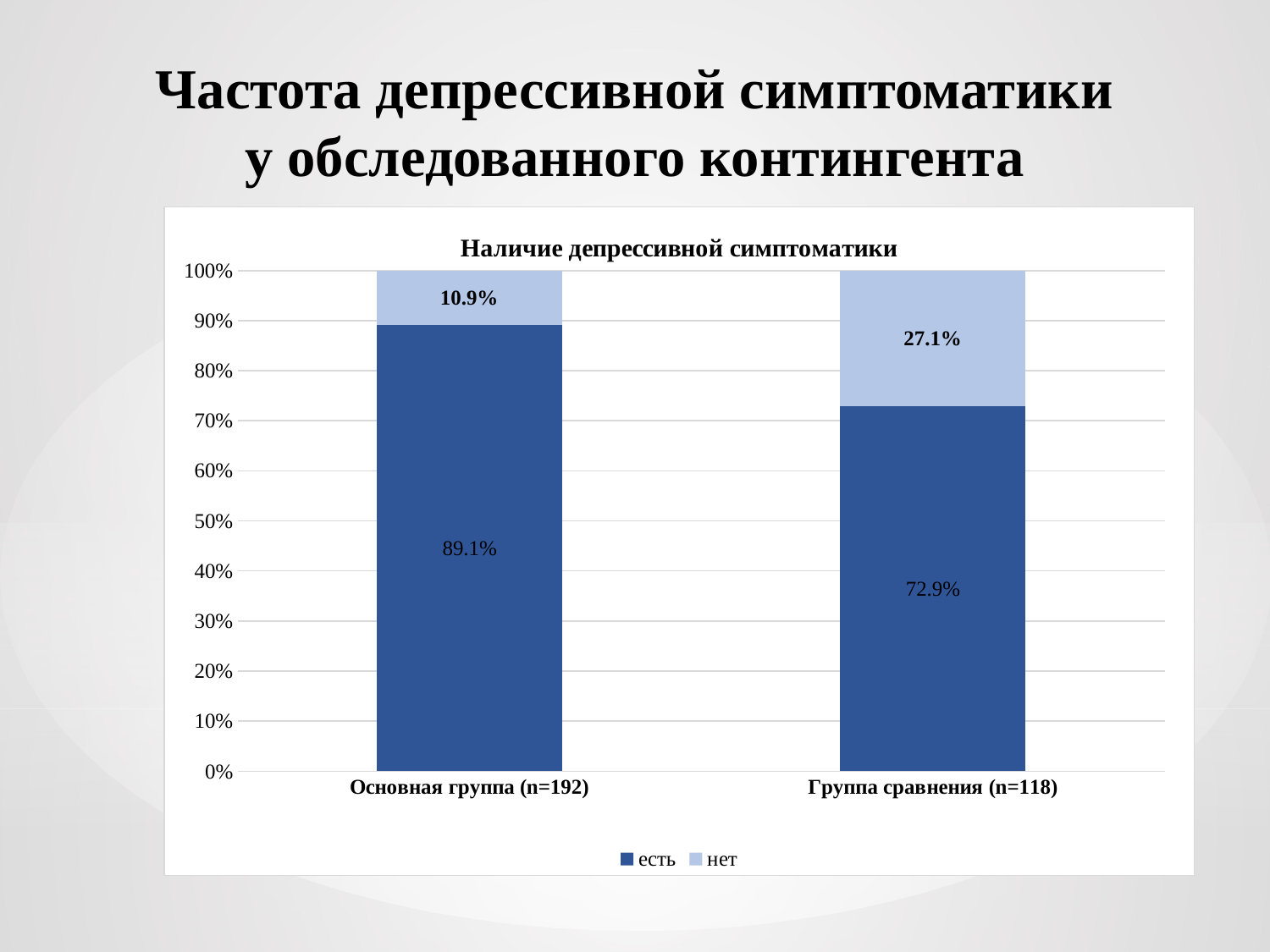
Which category has the higher value for "есть"? Основная группа (n=192) What is the title of the chart? Наличие депрессивной симптоматики What is the value of "есть" for Группа сравнения (n=118)? 72.9% What is the difference between the "есть" values for Основная группа (n=192) and Группа сравнения (n=118)? 16.2% Which category has the lower value for "нет"? Основная группа (n=192) How many series does the legend list? 2 How many categories are shown on the x axis? 2 What is the value of "нет" for Основная группа (n=192)? 10.9% What is the value of "есть" for Основная группа (n=192)? 89.1% What kind of chart is shown on the slide? stacked bar chart Is the "нет" value for Группа сравнения (n=118) larger or smaller than the "нет" value for Основная группа (n=192)? larger What is the value of "нет" for Группа сравнения (n=118)? 27.1%